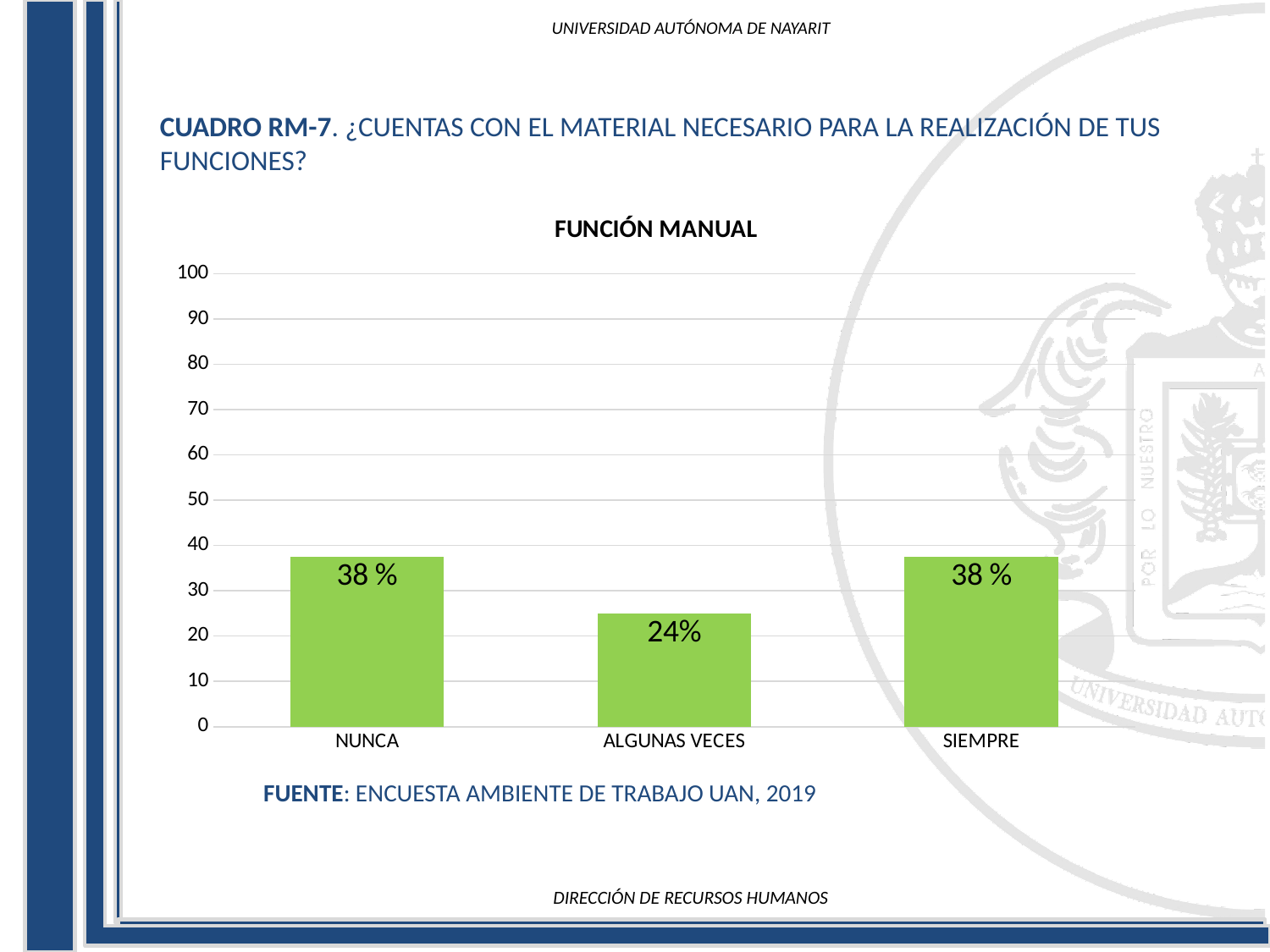
What kind of chart is shown on the slide? bar chart What is the value for SIEMPRE? 38 % What is the difference between the value for SIEMPRE and the value for ALGUNAS VECES? 14 percentage points Is the value for ALGUNAS VECES greater or less than 30? less What is the title of the chart? FUNCIÓN MANUAL Which category has the lowest value? ALGUNAS VECES How many categories are shown on the x axis? 3 Is the value for NUNCA greater or less than 30? greater What is the value for NUNCA? 38 % Which is larger, the value for NUNCA or the value for ALGUNAS VECES? NUNCA What is the value for ALGUNAS VECES? 24% What colour are the bars in the chart? green